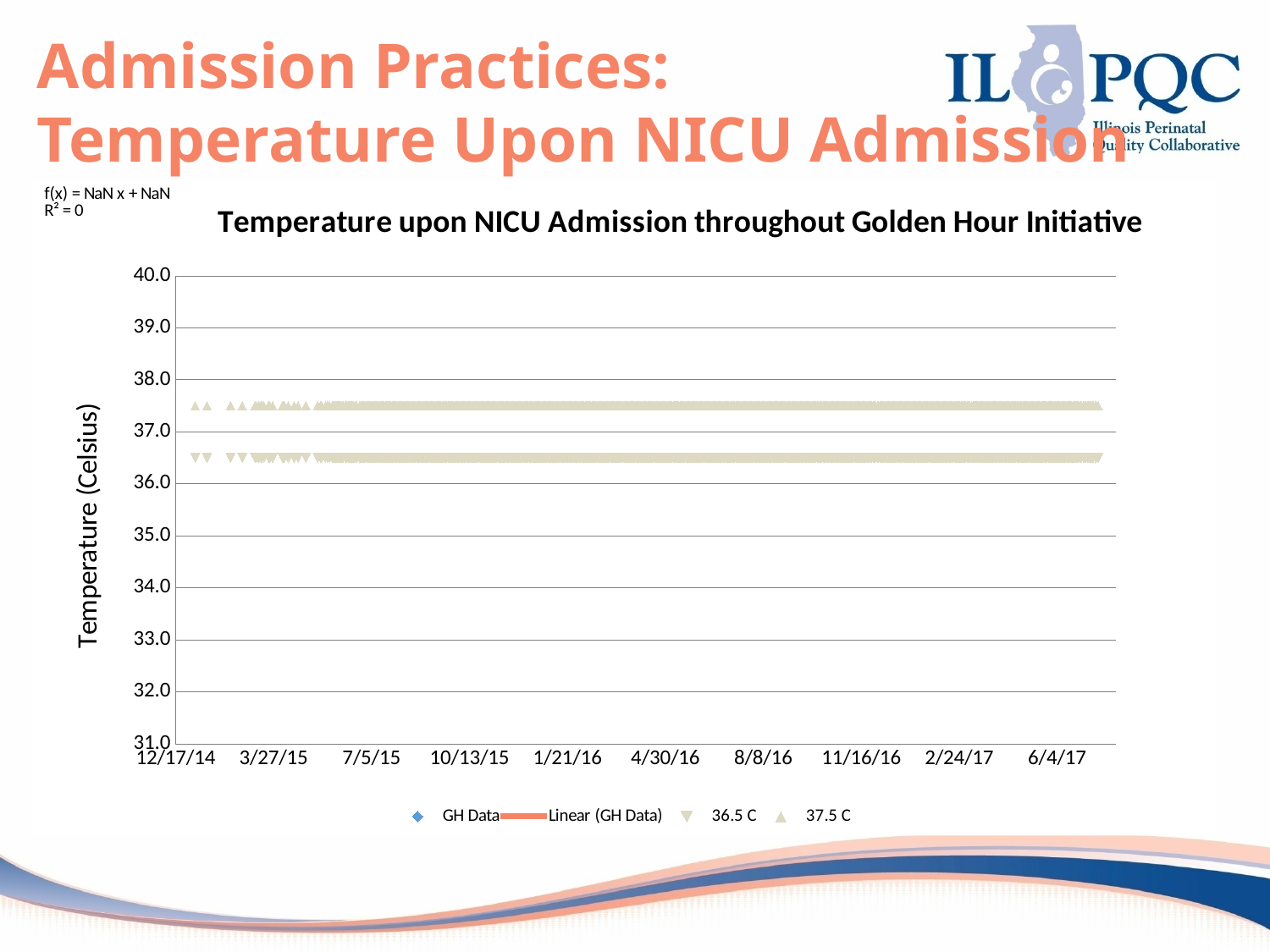
What is the difference between the two reference temperatures shown in the legend, 37.5 C and 36.5 C? 1.0 C Is the value of the 37.5 C reference series greater or less than 37.0? greater Is the value of the 36.5 C reference series greater or less than 37.0? less What is the label of the y axis? Temperature (Celsius) How many series does the chart legend list? 4 What is the title of the chart? Temperature upon NICU Admission throughout Golden Hour Initiative What temperature does the upper reference series (triangles pointing up) represent, according to the legend? 37.5 C What temperature does the lower reference series (triangles pointing down) represent, according to the legend? 36.5 C Which reference series is plotted higher on the chart, 36.5 C or 37.5 C? 37.5 C What is the R² value printed above the chart? R² = 0 What kind of chart is shown on the slide? scatter chart Do the plotted reference series rise, fall, or stay flat across the x axis? stay flat